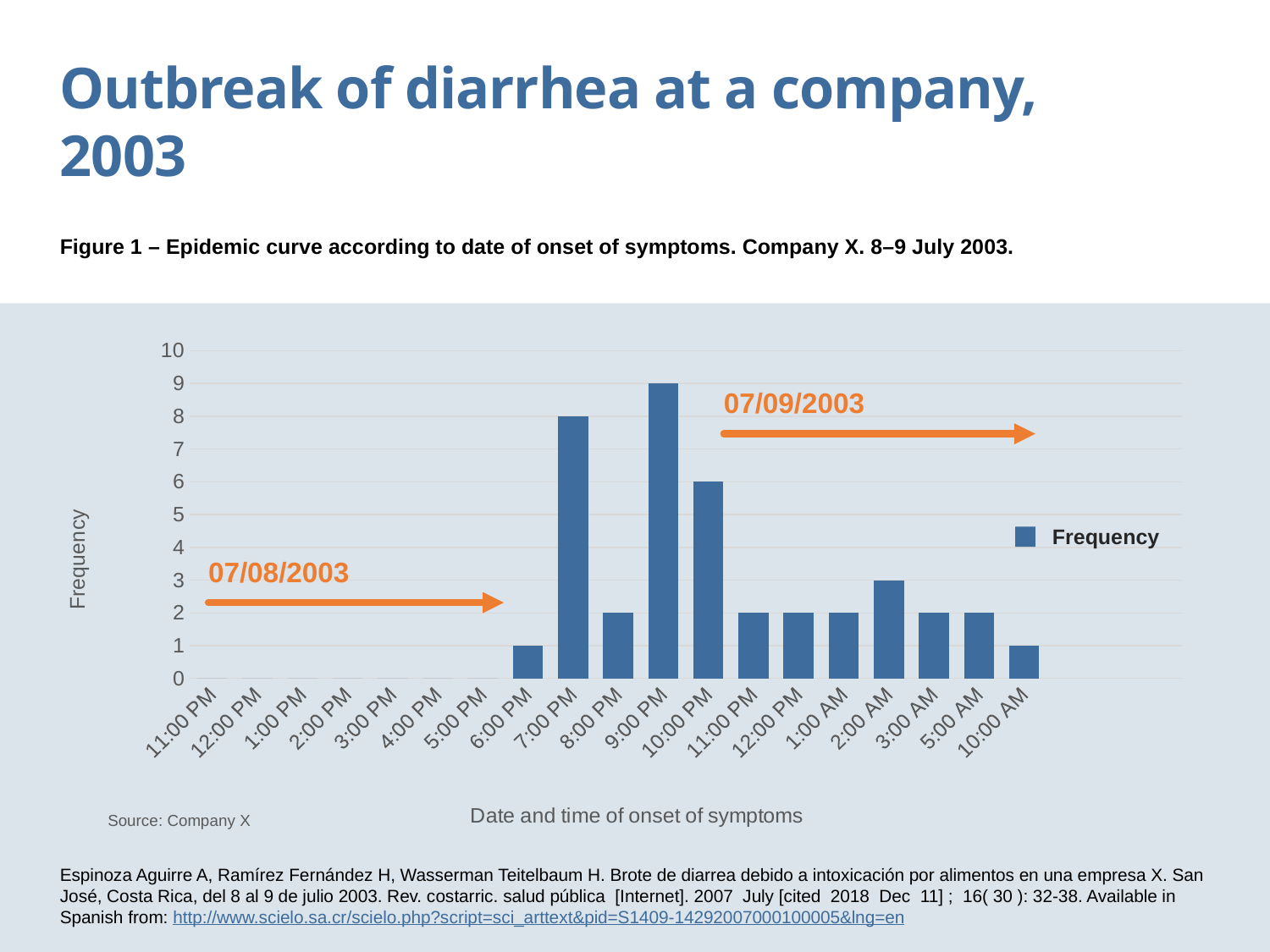
Which has a higher frequency, 10:00 PM or 8:00 PM? 10:00 PM Which time of onset has the highest frequency? 9:00 PM What is the frequency for 2:00 AM? 3 Is the frequency for 9:00 PM greater or less than 5? greater What is the frequency for 7:00 PM? 8 How many series does the legend list? 1 What is the label on the vertical axis of the chart? Frequency What kind of chart is shown on the slide? bar chart What is the frequency for 9:00 PM? 9 What is the frequency for 6:00 PM? 1 What is the difference between the frequency at 9:00 PM and the frequency at 7:00 PM? 1 What is the frequency for 10:00 PM? 6